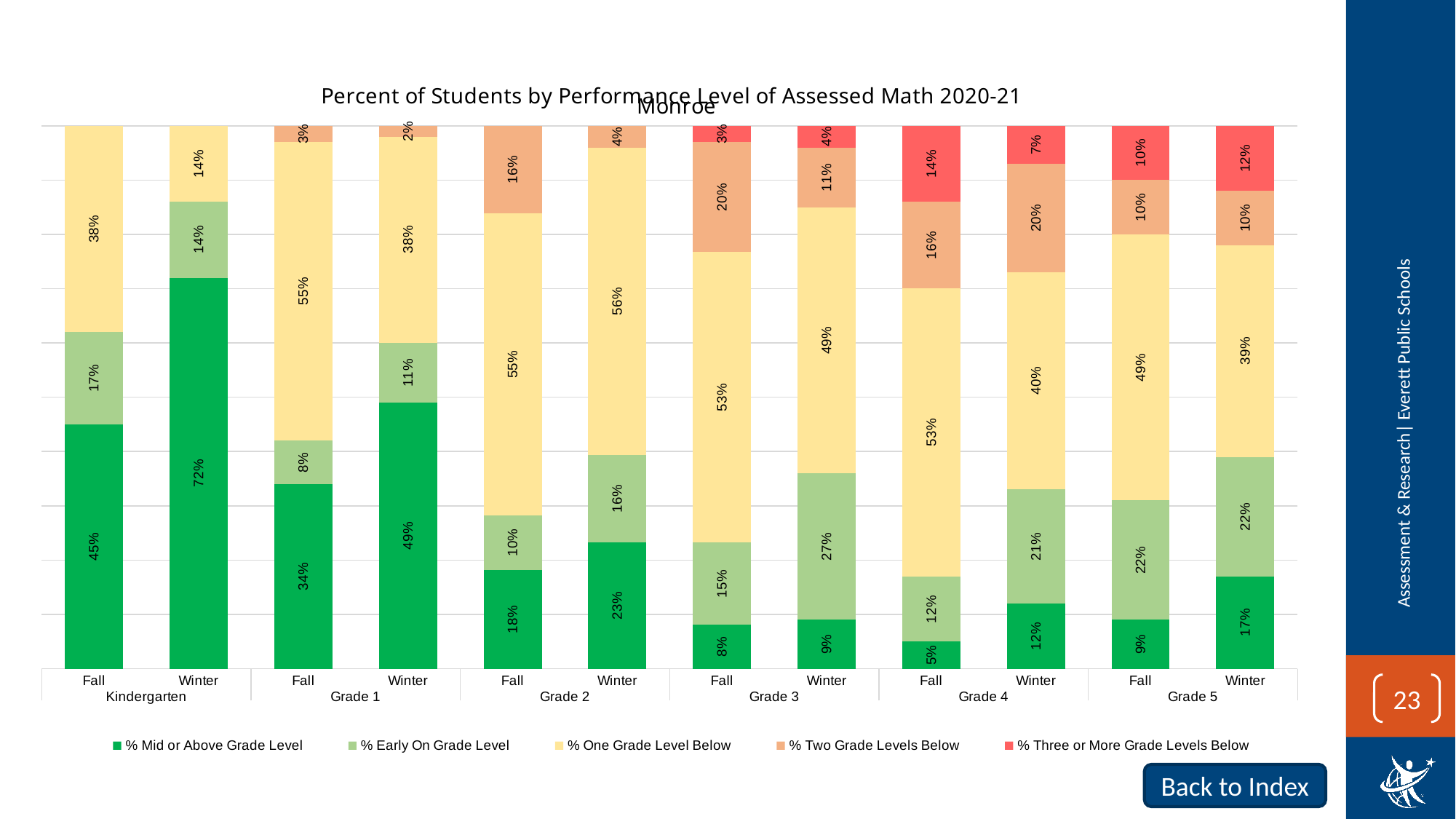
What percentage of Grade 3 students were Two Grade Levels Below in Fall? 20% Which Fall/Winter bar has the highest % Mid or Above Grade Level value? Kindergarten Winter What kind of chart is shown on the slide? Stacked bar chart Which Fall/Winter bar has the lowest % Mid or Above Grade Level value? Grade 4 Fall What is the combined percentage of Grade 2 Fall students who were Mid or Above Grade Level or Early On Grade Level? 28% How many bars are plotted in the chart? 12 What percentage of Grade 5 students were Three or More Grade Levels Below in Winter? 12% How many series does the legend list? 5 Which legend entry is shown in dark green? % Mid or Above Grade Level What percentage of Kindergarten students were Mid or Above Grade Level in Winter? 72% What is the difference between the % Mid or Above Grade Level for Grade 1 Winter and Grade 1 Fall? 15% Which is larger: the % Early On Grade Level for Grade 3 Winter or for Grade 3 Fall? Grade 3 Winter